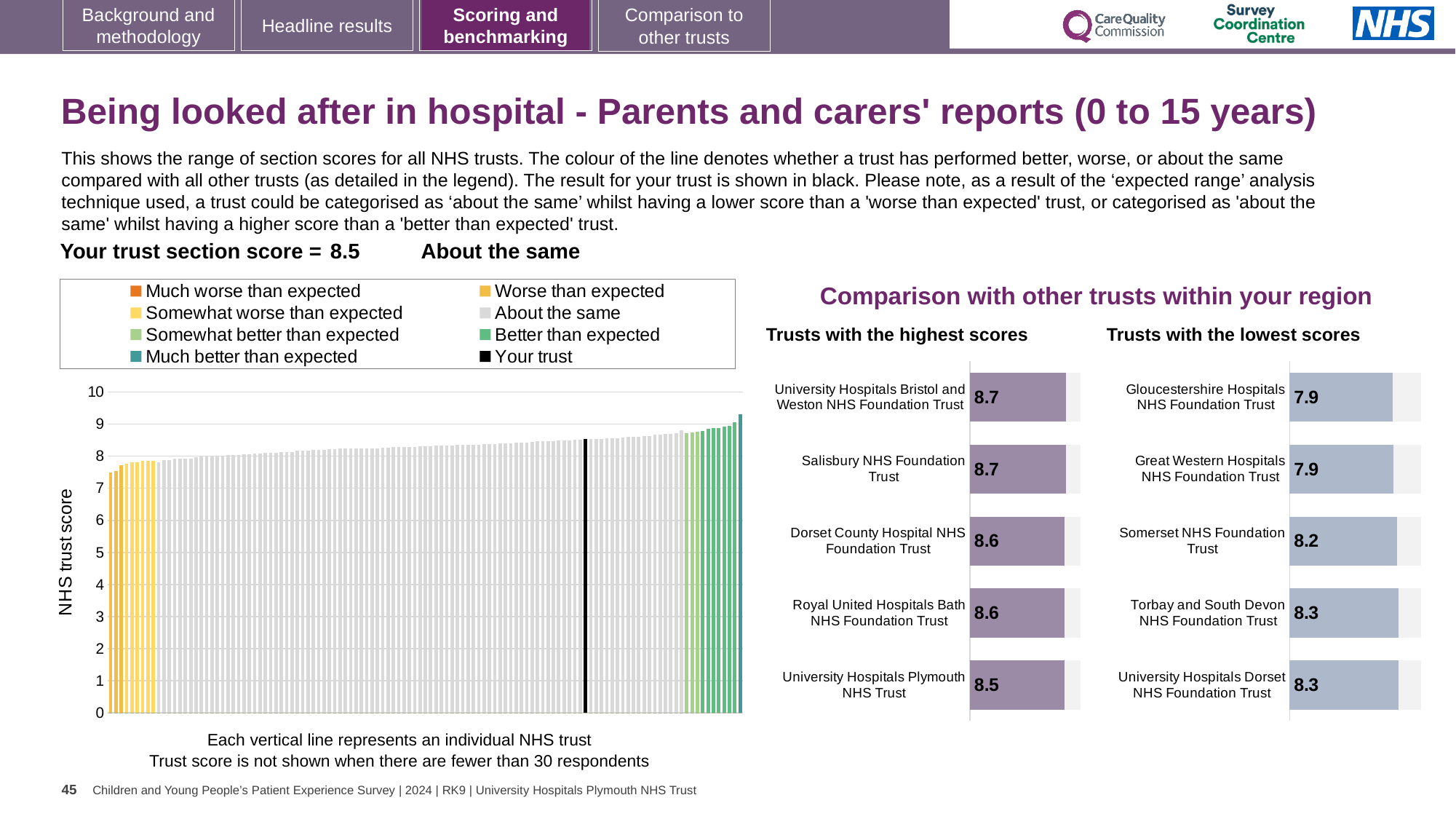
In the 'Trusts with the lowest scores' chart, what is the score for Somerset NHS Foundation Trust? 8.2 In the 'Trusts with the lowest scores' chart, what is the difference between the score for Somerset NHS Foundation Trust and the score for Great Western Hospitals NHS Foundation Trust? 0.3 In the large 'NHS trust score' chart on the left, is the value for the black 'Your trust' bar greater or less than 8? greater How many entries does the legend above the large 'NHS trust score' chart list? 8 In the 'Trusts with the highest scores' chart, which trust has the lowest score? University Hospitals Plymouth NHS Trust How many trusts are shown in the 'Trusts with the lowest scores' chart? 5 In the 'Trusts with the lowest scores' chart, what is the score for Gloucestershire Hospitals NHS Foundation Trust? 7.9 In the 'Trusts with the highest scores' chart, what is the difference between the score for University Hospitals Bristol and Weston NHS Foundation Trust and the score for University Hospitals Plymouth NHS Trust? 0.2 In the 'Trusts with the lowest scores' chart, which is larger: the score for Torbay and South Devon NHS Foundation Trust or the score for Gloucestershire Hospitals NHS Foundation Trust? Torbay and South Devon NHS Foundation Trust In the 'Trusts with the highest scores' chart, what is the score for University Hospitals Plymouth NHS Trust? 8.5 In the large 'NHS trust score' chart on the left, do the bar values rise or fall from left to right? rise In the 'Trusts with the highest scores' chart, what is the score for Dorset County Hospital NHS Foundation Trust? 8.6